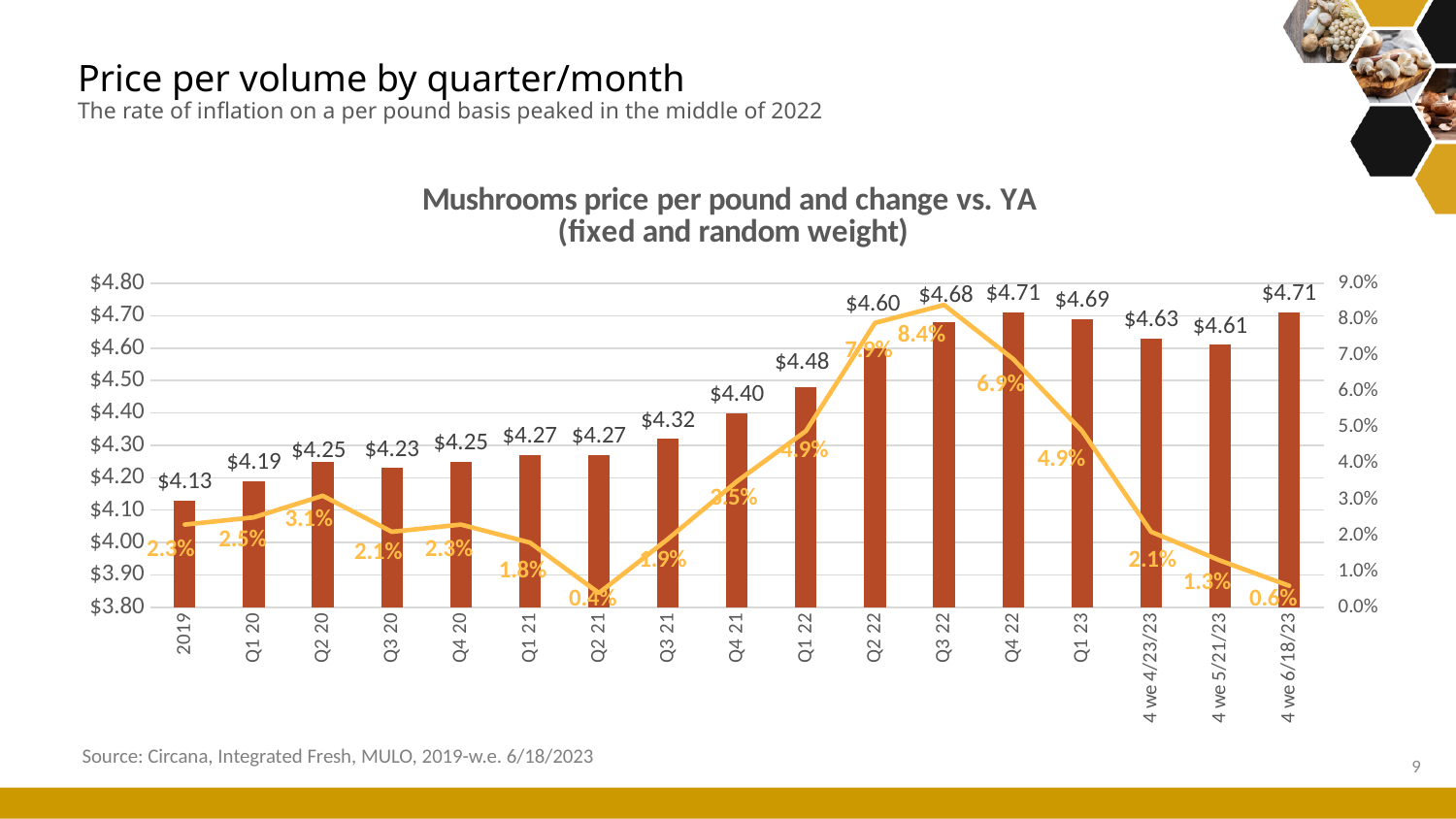
How many periods are shown on the x axis? 17 What is the title of the chart? Mushrooms price per pound and change vs. YA (fixed and random weight) What is the change vs. YA shown for Q2 21? 0.4% What is the price per pound shown for the 4 we 6/18/23 period? $4.71 Which is higher, the price per pound for Q1 23 or for 4 we 5/21/23? Q1 23 What is the change vs. YA shown for Q3 22? 8.4% What is the mushrooms price per pound for Q1 22? $4.48 Which period has the lowest price per pound? 2019 Which period has the highest change vs. YA? Q3 22 Which period has the lowest change vs. YA? Q2 21 What kind of chart is this? Combination bar and line chart What is the difference in price per pound between Q4 22 and 2019? $0.58